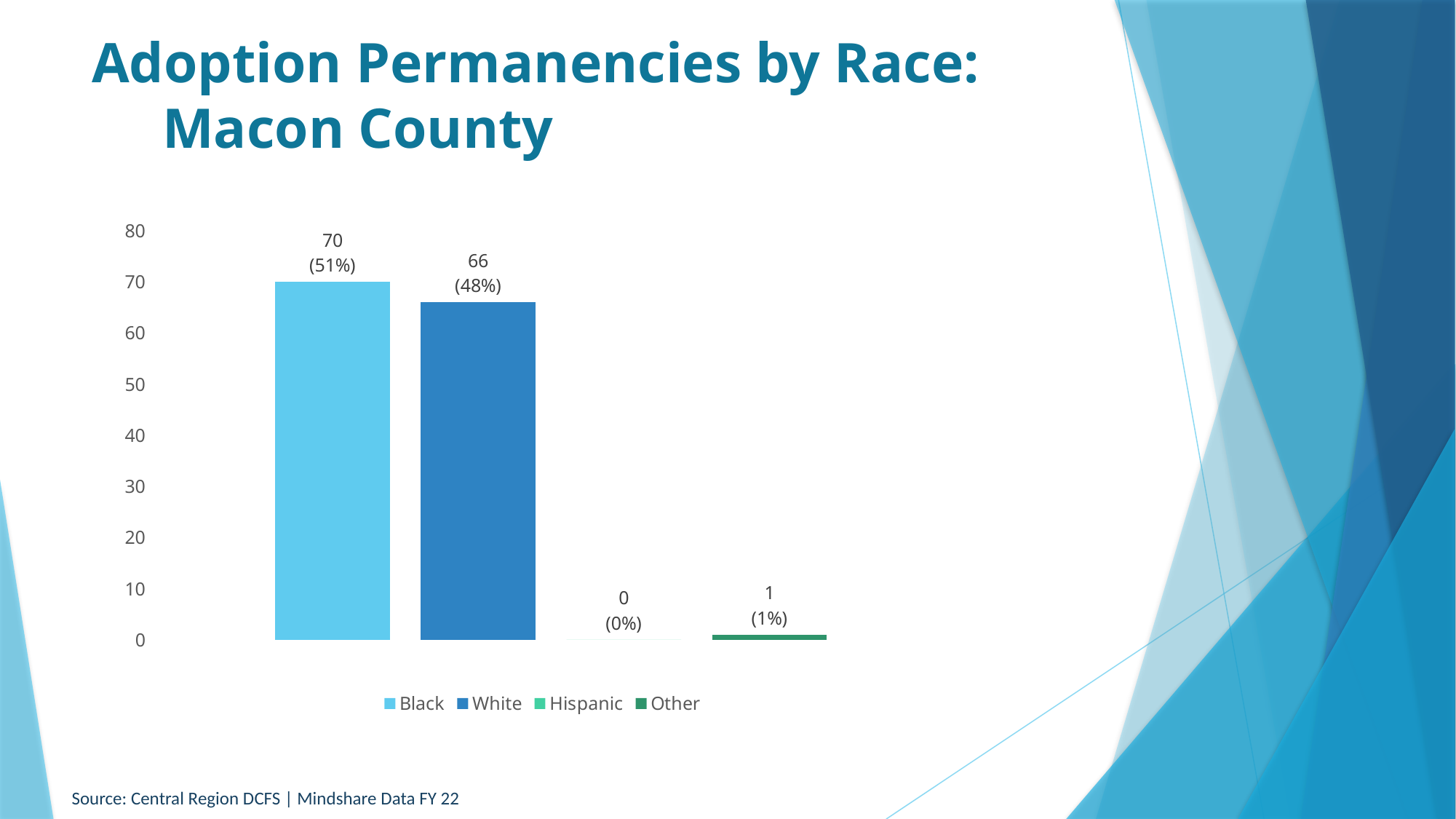
Which race has the lowest number of adoption permanencies? Hispanic What is the source cited for the chart data? Central Region DCFS | Mindshare Data FY 22 Which is larger, the value for White or the value for Other? White What is the value shown for Other? 1 What is the value shown for Hispanic? 0 What is the difference between the Black and White values? 4 How many adoption permanencies are shown for Black in Macon County? 70 What percentage of adoption permanencies is shown for White? 48% What kind of chart is shown on the slide? Bar chart How many race categories does the legend list? 4 Is the value for White greater or less than 60? greater Which race has the highest number of adoption permanencies? Black